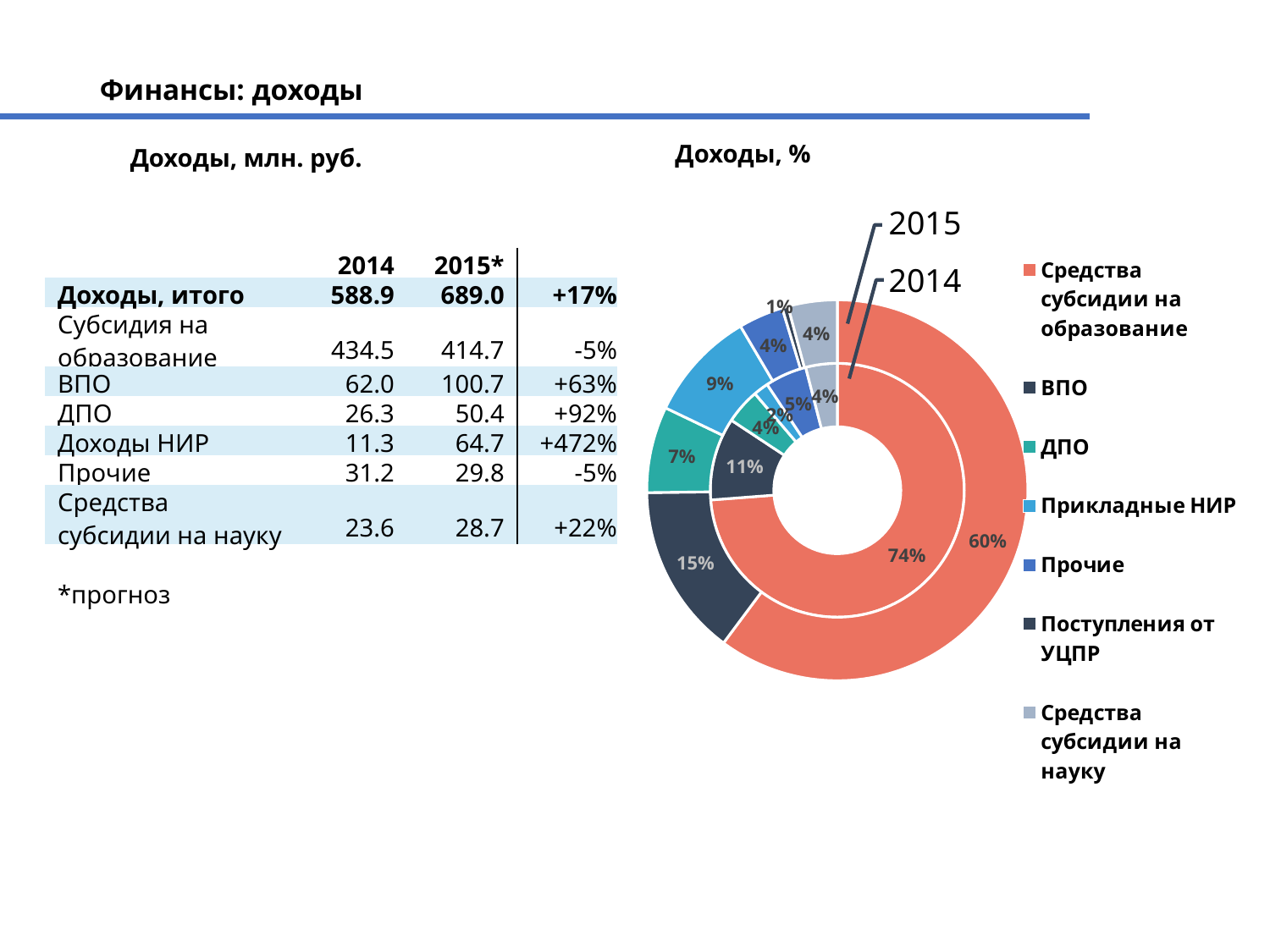
In the "Доходы, %" chart, what share does "Средства субсидии на образование" have in the 2015 (outer) ring? 60% In the "Доходы, %" chart, by how many percentage points did the share of "Средства субсидии на образование" fall from 2014 to 2015? 14 percentage points In the "Доходы, %" chart, which category has the largest share in the 2015 ring? Средства субсидии на образование In the "Доходы, %" chart, what is the share of "ДПО" in 2015? 7% In the "Доходы, %" chart, what is the share of "Прикладные НИР" in 2015? 9% What kind of chart is shown under the title "Доходы, %"? Doughnut (pie) chart In the "Доходы, %" chart, is the share of "ВПО" larger in 2014 or in 2015? 2015 In the "Доходы, %" chart, what share does "Средства субсидии на образование" have in the 2014 (inner) ring? 74% In the "Доходы, %" chart, which category has the smallest share in the 2015 ring? Поступления от УЦПР How many entries does the legend of the "Доходы, %" chart list? 7 In the "Доходы, %" chart, what is the share of "ВПО" in 2014? 11% In the "Доходы, %" chart, what is the share of "ВПО" in 2015? 15%